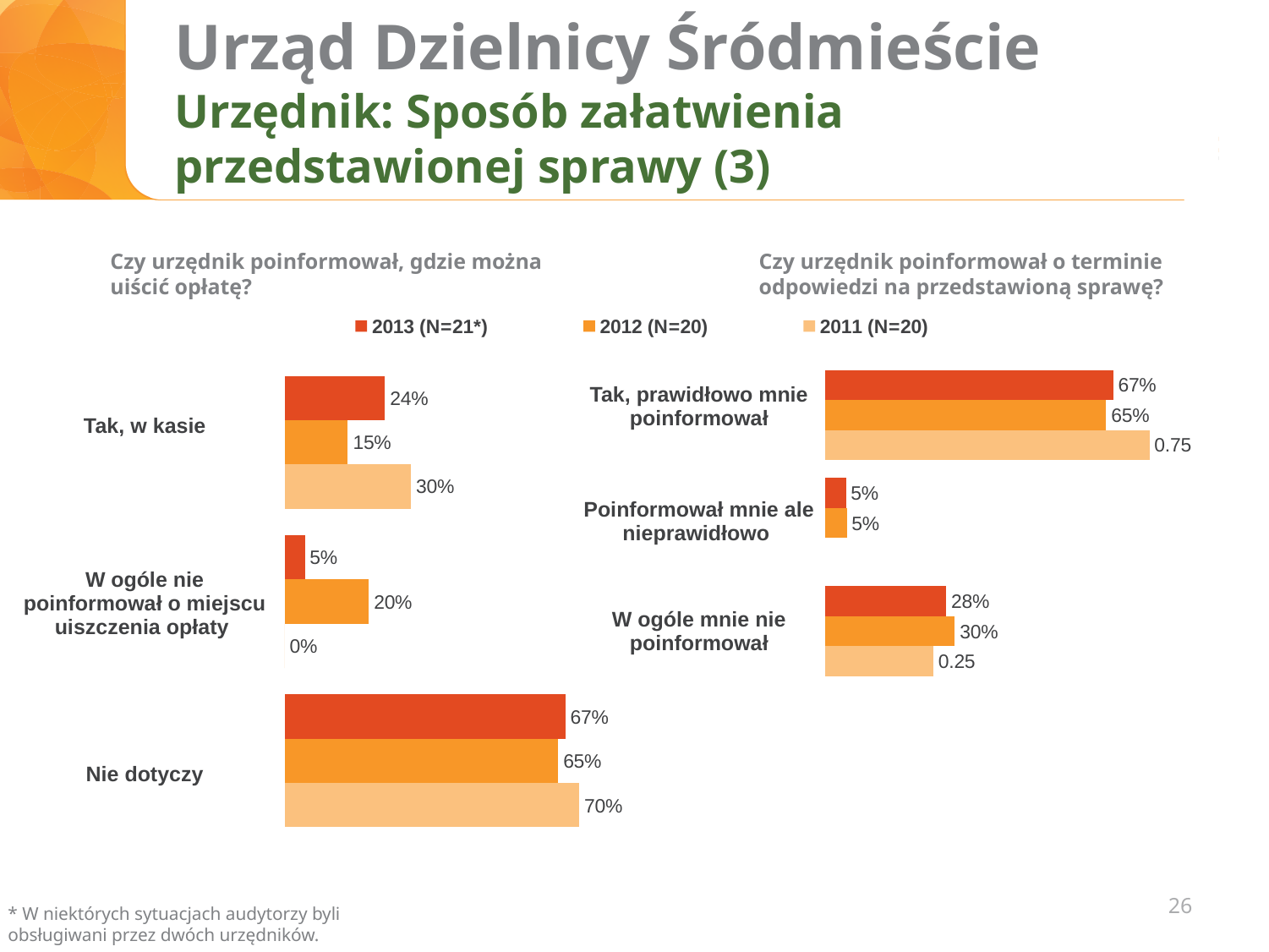
In the right chart ("Czy urzędnik poinformował o terminie odpowiedzi na przedstawioną sprawę?"), what is the value for "W ogóle mnie nie poinformował" in 2011 (N=20)? 0.25 In the right chart ("Czy urzędnik poinformował o terminie odpowiedzi na przedstawioną sprawę?"), how many categories are shown? 3 What type of chart is the left chart ("Czy urzędnik poinformował, gdzie można uiścić opłatę?")? Bar chart How many series does the legend list? 3 In the right chart ("Czy urzędnik poinformował o terminie odpowiedzi na przedstawioną sprawę?"), which is larger for "W ogóle mnie nie poinformował": the 2013 value or the 2012 value? 2012 (N=20) In the left chart ("Czy urzędnik poinformował, gdzie można uiścić opłatę?"), what is the value for "Tak, w kasie" in 2013 (N=21*)? 24% In the left chart ("Czy urzędnik poinformował, gdzie można uiścić opłatę?"), what is the value for "Nie dotyczy" in 2011 (N=20)? 70% In the right chart ("Czy urzędnik poinformował o terminie odpowiedzi na przedstawioną sprawę?"), what is the value for "Poinformował mnie ale nieprawidłowo" in 2012 (N=20)? 5% In the right chart ("Czy urzędnik poinformował o terminie odpowiedzi na przedstawioną sprawę?"), what is the value for "Tak, prawidłowo mnie poinformował" in 2013 (N=21*)? 67% In the left chart ("Czy urzędnik poinformował, gdzie można uiścić opłatę?"), what is the value for "W ogóle nie poinformował o miejscu uiszczenia opłaty" in 2012 (N=20)? 20% In the left chart ("Czy urzędnik poinformował, gdzie można uiścić opłatę?"), which category has the highest value for 2013 (N=21*)? Nie dotyczy In the left chart ("Czy urzędnik poinformował, gdzie można uiścić opłatę?"), what is the difference between the 2011 and 2012 values for "Tak, w kasie"? 15%